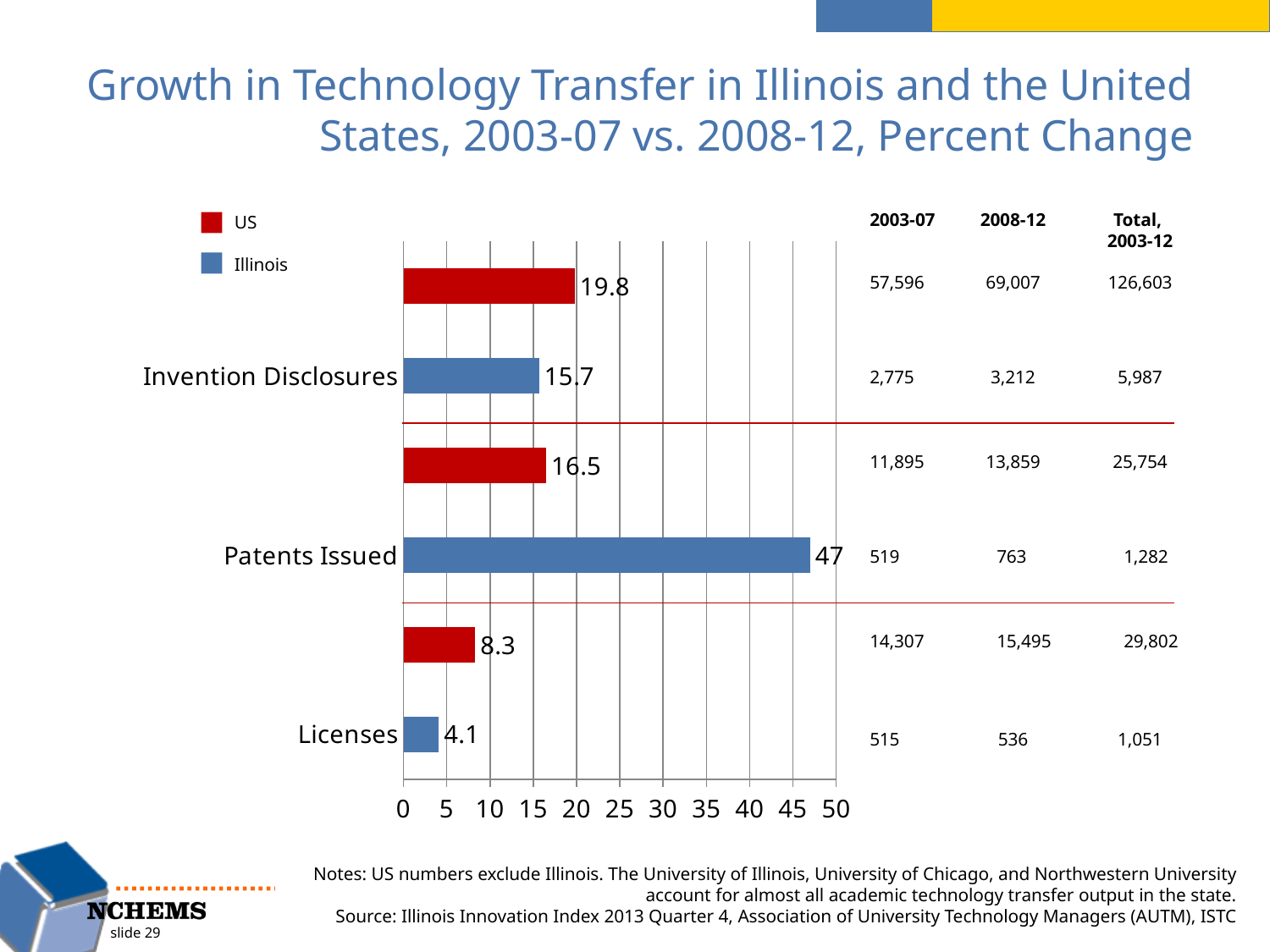
What is the percent change for the US in Invention Disclosures? 19.8 What is the percent change for the US in Licenses? 8.3 What is the percent change for Illinois in Patents Issued? 47 How many categories are shown on the chart? 3 Is the Illinois value for Patents Issued greater or less than 45? greater What kind of chart is shown on the slide? Bar chart For Invention Disclosures, which is larger: the US or Illinois percent change? US What is the percent change for Illinois in Licenses? 4.1 What is the difference between the Illinois and US percent change for Patents Issued? 30.5 Which category has the highest percent change for Illinois? Patents Issued Which category has the lowest percent change for the US? Licenses How many series does the legend list? 2